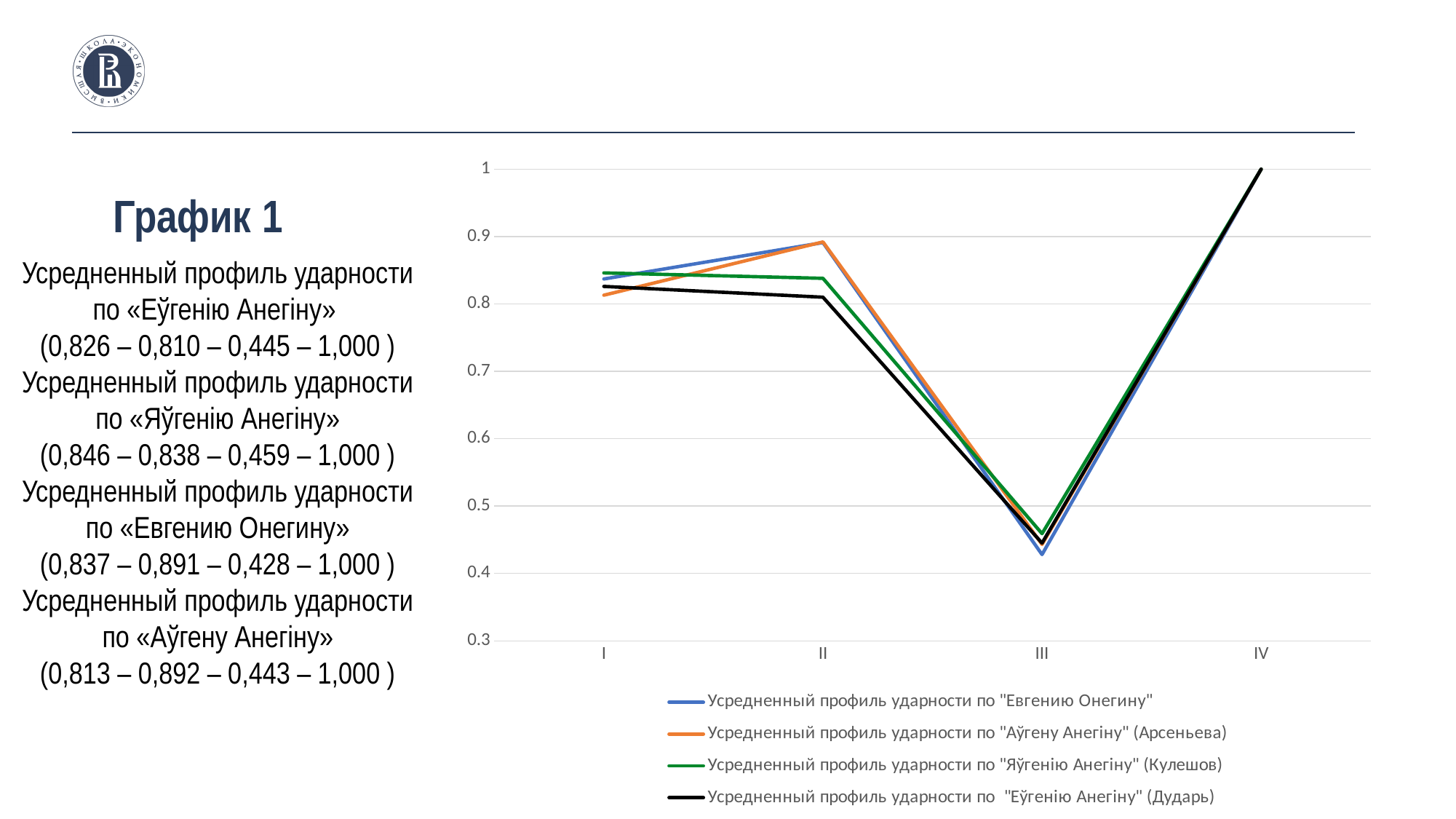
What is the value at position II for the series "Усредненный профиль ударности по «Аўгену Анегіну»"? 0,892 Do the values rise or fall from position II to position III? fall At which x-axis position do all series reach their highest value? IV At which x-axis position do all series reach their lowest value? III What colour is the line for "Усредненный профиль ударности по «Евгению Онегину»"? blue How many series does the legend list? 4 Is the value at position III for the series "Яўгенію Анегіну" greater or less than 0.5? less What is the difference between the values at positions II and III for the series "Яўгенію Анегіну"? 0,379 At position II, which series has the larger value: "Евгению Онегину" or "Еўгенію Анегіну"? Евгению Онегину How many points are plotted along the x axis for each series? 4 What kind of chart is shown on the slide? line chart What is the value at position III for the series "Усредненный профиль ударности по «Евгению Онегину»"? 0,428